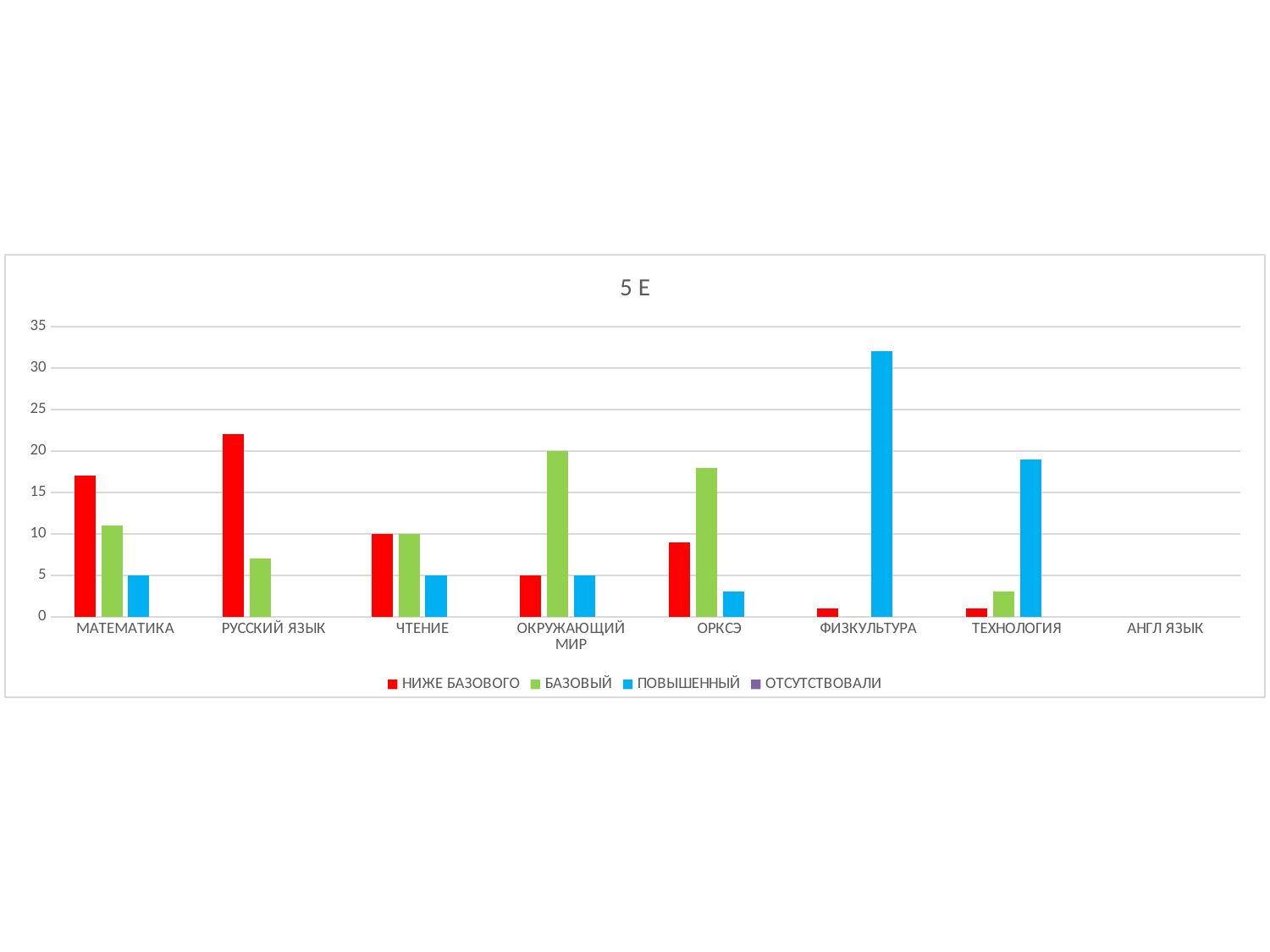
What is the value of ПОВЫШЕННЫЙ for МАТЕМАТИКА? 5 What is the title of the chart? 5 Е For МАТЕМАТИКА, which is larger: НИЖЕ БАЗОВОГО or БАЗОВЫЙ? НИЖЕ БАЗОВОГО What type of chart is shown on the slide? bar chart What is the value of БАЗОВЫЙ for ОКРУЖАЮЩИЙ МИР? 20 Which subject has the highest НИЖЕ БАЗОВОГО value? РУССКИЙ ЯЗЫК How many series does the legend list? 4 How many subject categories are shown on the x axis? 8 Is the ПОВЫШЕННЫЙ value for ФИЗКУЛЬТУРА greater or less than 30? greater Which subject has the highest ПОВЫШЕННЫЙ value? ФИЗКУЛЬТУРА What is the value of НИЖЕ БАЗОВОГО for ЧТЕНИЕ? 10